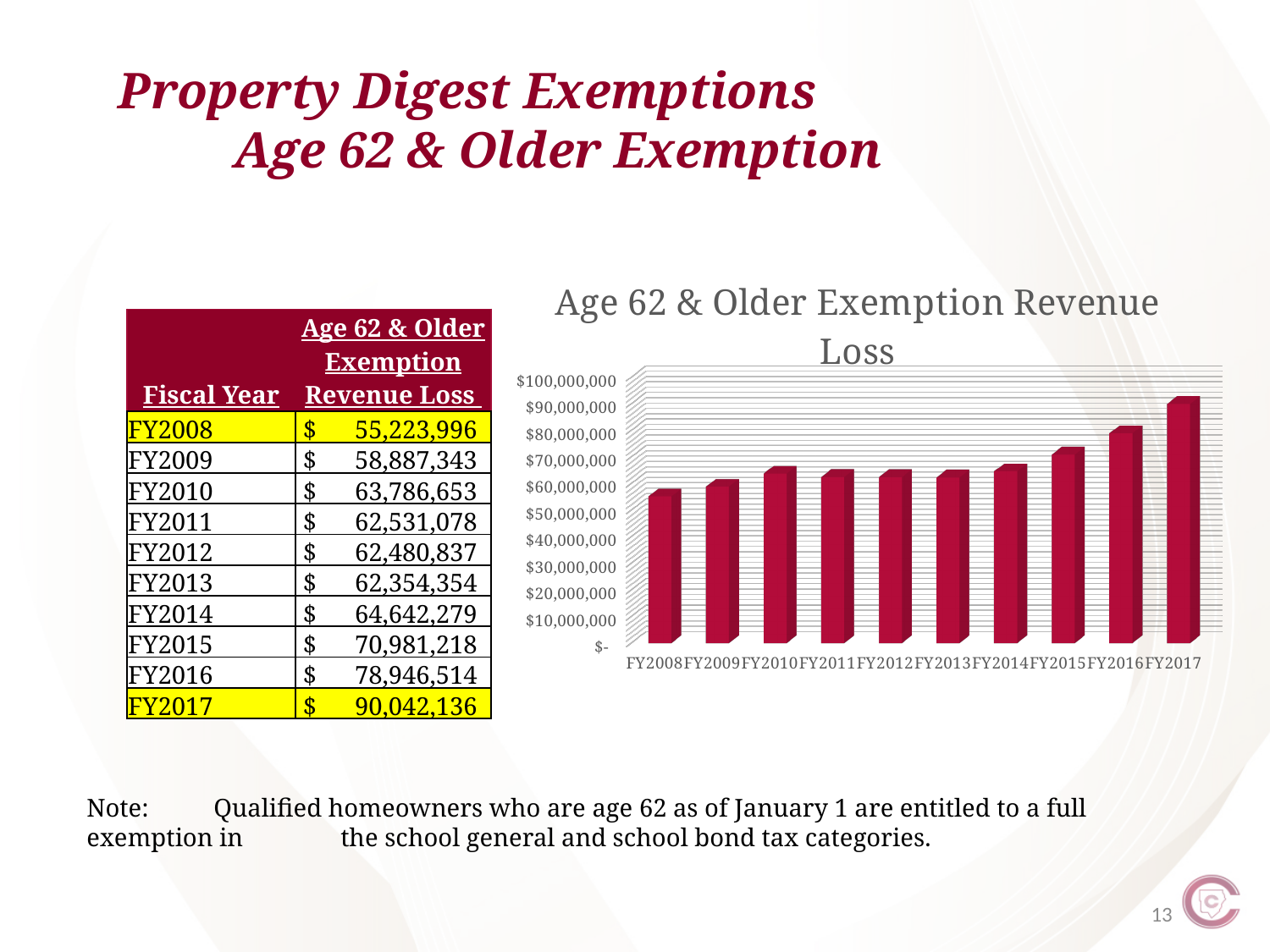
What is the difference between the revenue loss in FY2017 and FY2008? $34,818,140 Is the revenue loss for FY2016 greater or less than $70,000,000? greater Which fiscal year has the highest Age 62 & Older Exemption Revenue Loss? FY2017 What is the Age 62 & Older Exemption Revenue Loss for FY2015? $ 70,981,218 Is the revenue loss for FY2008 greater or less than $60,000,000? less What type of chart is shown on the slide? Bar chart What is the title of the chart? Age 62 & Older Exemption Revenue Loss What is the Age 62 & Older Exemption Revenue Loss for FY2017? $ 90,042,136 How many fiscal years are plotted in the chart? 10 What is the Age 62 & Older Exemption Revenue Loss for FY2008? $ 55,223,996 Which is larger, the revenue loss for FY2010 or for FY2009? FY2010 Which fiscal year has the lowest Age 62 & Older Exemption Revenue Loss? FY2008